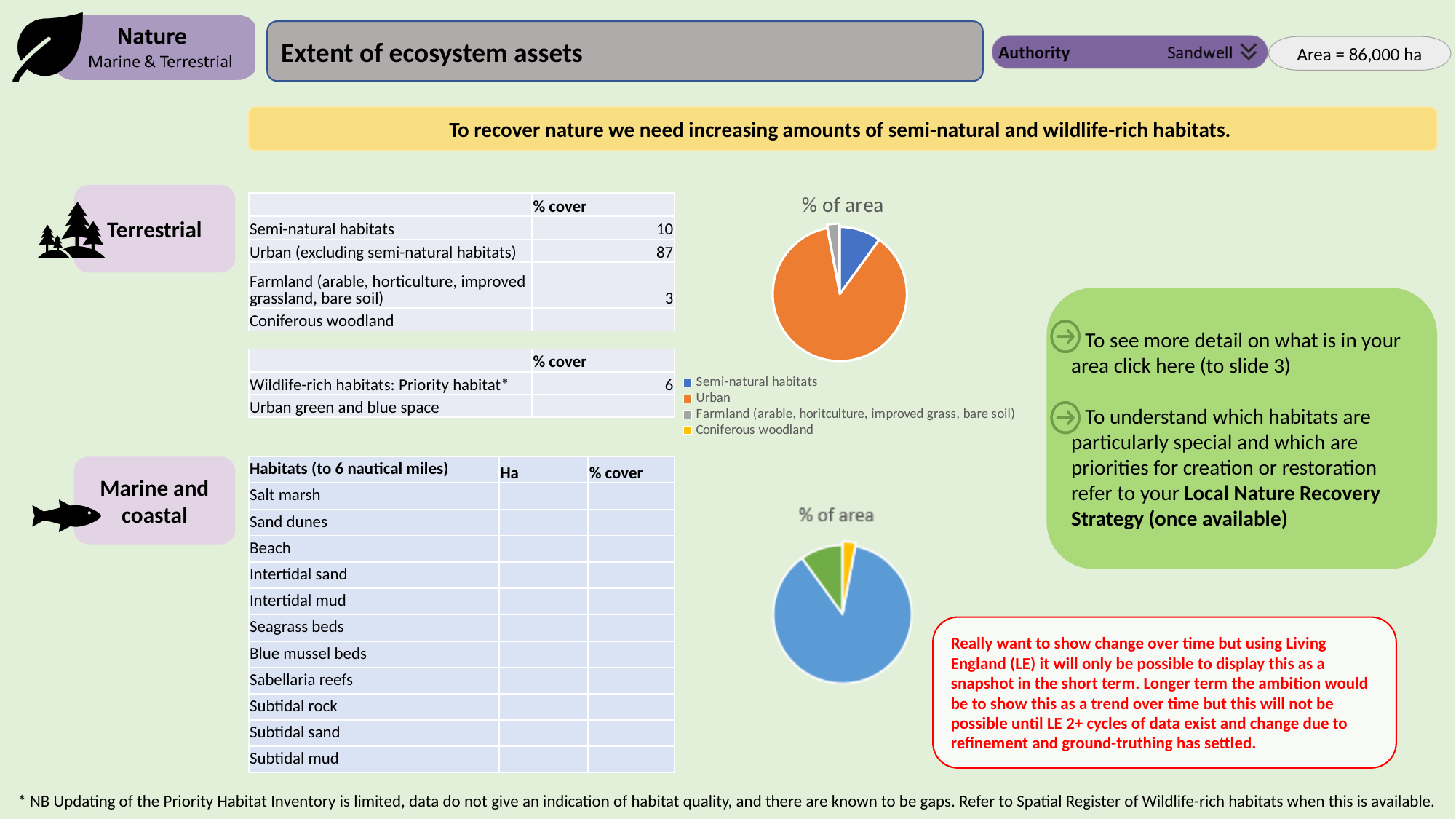
In the top '% of area' pie chart, which slice is larger: Urban or Semi-natural habitats? Urban What kind of chart is the top '% of area' chart next to the Terrestrial table? pie chart In the top '% of area' pie chart, which category has the largest slice? Urban In the lower '% of area' pie chart next to the Marine and coastal table, which coloured slice is the largest? blue How many slices does the lower '% of area' pie chart next to the Marine and coastal table have? 3 In the lower '% of area' pie chart next to the Marine and coastal table, which coloured slice is the smallest? yellow How many categories does the legend of the top '% of area' pie chart list? 4 In the top '% of area' pie chart, which slice is larger: Semi-natural habitats or Farmland (arable, horitculture, improved grass, bare soil)? Semi-natural habitats What colour is the Urban slice in the top '% of area' pie chart? orange What kind of chart is the lower '% of area' chart next to the Marine and coastal table? pie chart What is the title of the pie chart next to the Marine and coastal table? % of area